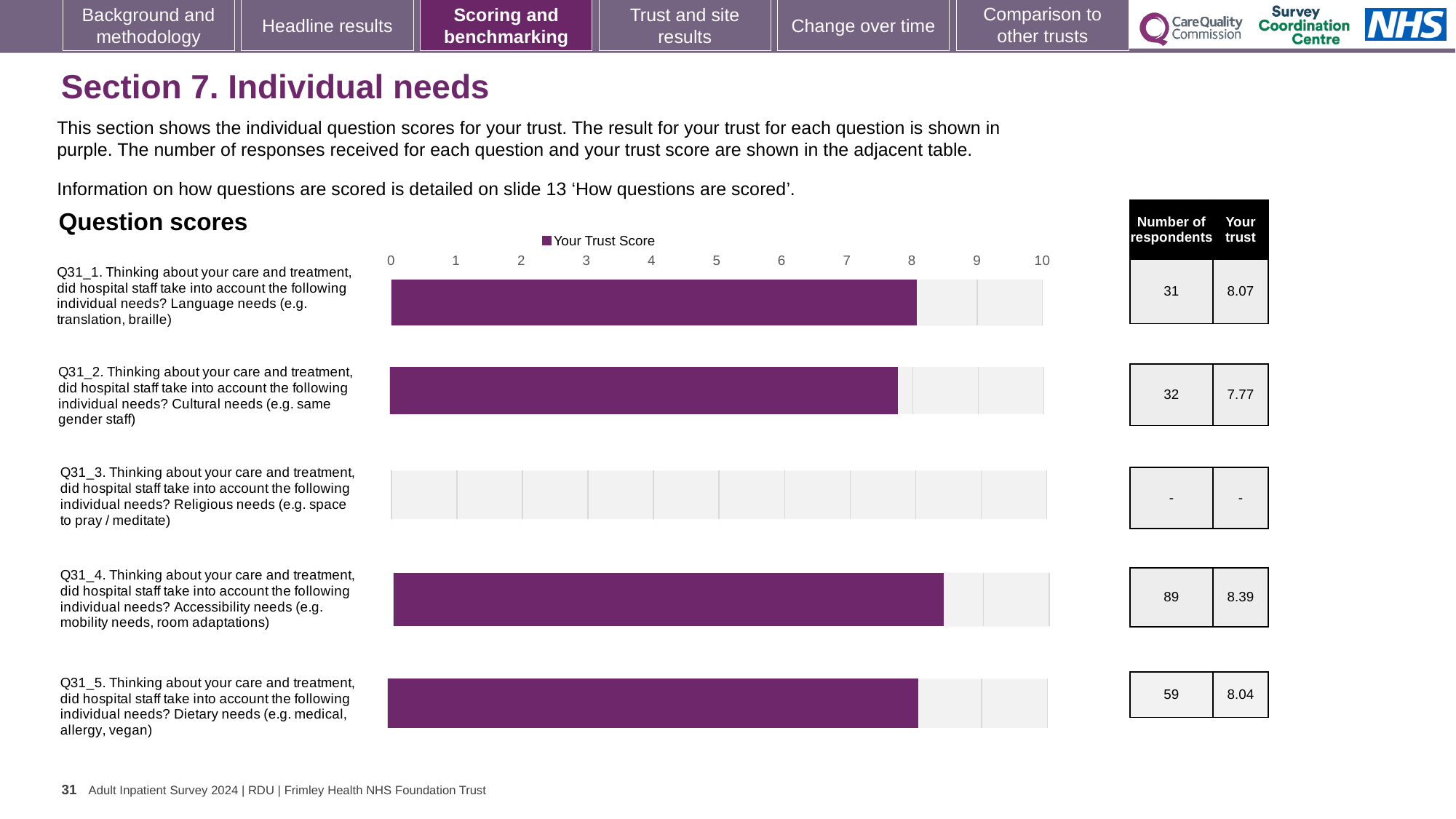
Among the questions with a score shown, which has the lowest trust score? Q31_2 (Cultural needs) Is the trust score for Q31_2 greater or less than 8? less How many respondents answered Q31_4? 89 What is the difference between the trust scores for Q31_4 and Q31_2? 0.62 Which question has the highest trust score? Q31_4 (Accessibility needs) How many series does the legend list? 1 How many questions are listed in the chart? 5 What is the trust score for Q31_4 (Accessibility needs)? 8.39 Which has the larger trust score, Q31_1 or Q31_5? Q31_1 What kind of chart is shown? Bar chart What is the trust score for Q31_5 (Dietary needs)? 8.04 What is the trust score for Q31_1 (Language needs)? 8.07